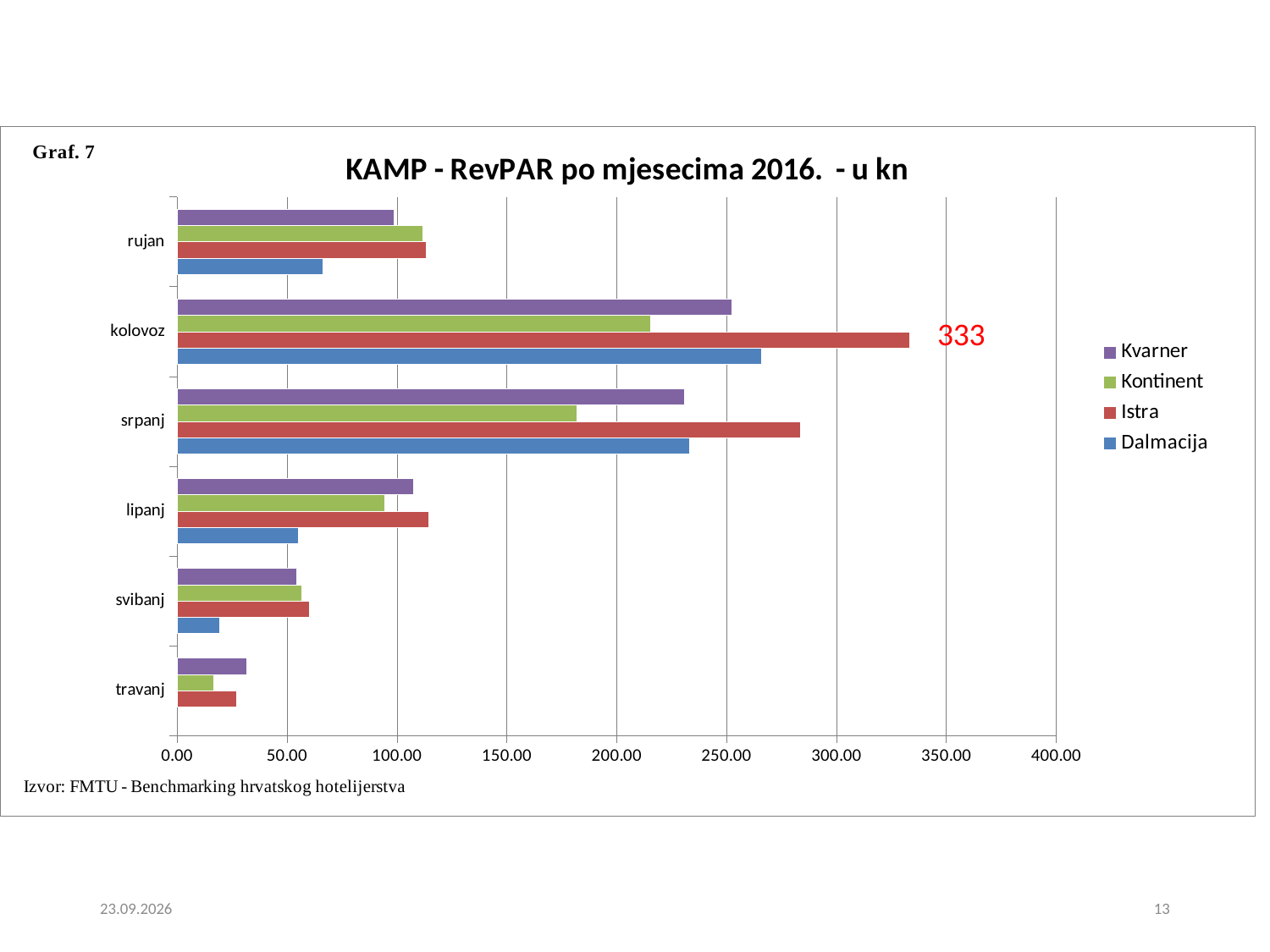
How many months (categories) are shown on the chart? 6 Which region has the highest value in kolovoz? Istra In kolovoz, which is larger: the Kvarner value or the Kontinent value? Kvarner What kind of chart is shown on the slide? bar chart What value is labelled on the Istra bar for kolovoz? 333 In which month is the Kontinent value lowest? travanj How many series does the legend list? 4 Which colour represents Istra in the legend? red What is the title of the chart? KAMP - RevPAR po mjesecima 2016. - u kn Is the value for Dalmacija in kolovoz greater or less than 250? greater Is the value for Kontinent in srpanj greater or less than 200? less In which month is the Istra value highest? kolovoz